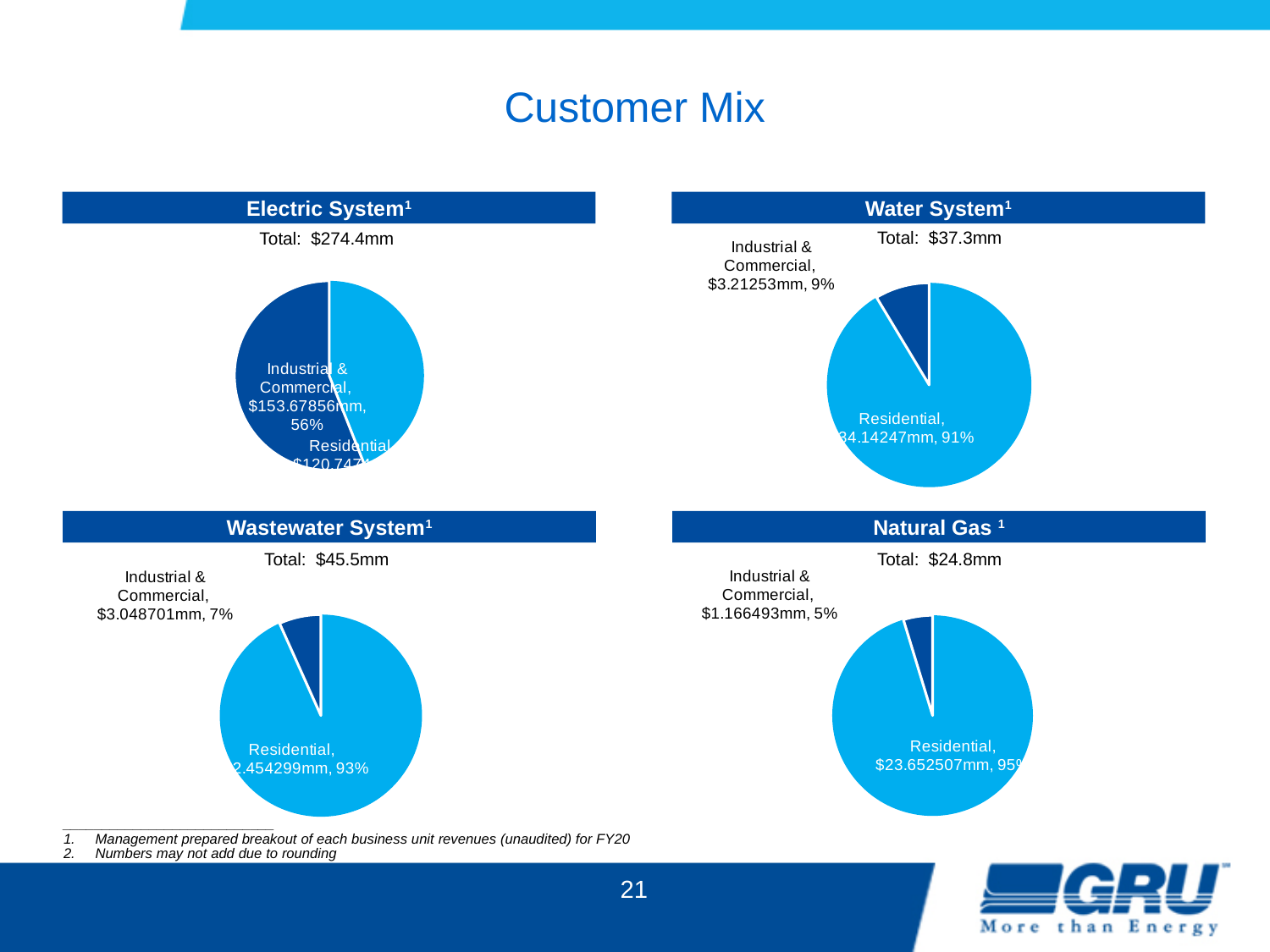
In the Wastewater System chart, what is the value for Industrial & Commercial? $3.048701mm In the Electric System chart, which slice is larger, Industrial & Commercial or Residential? Industrial & Commercial In the Natural Gas chart, what is the value for Residential? $23.652507mm In the Natural Gas chart, what share of the pie is Industrial & Commercial? 5% In the Wastewater System chart, what share of the pie is Residential? 93% What kind of chart is used for the Electric System? pie chart In the Water System chart, which slice is the largest? Residential In the Electric System chart, what is the value for Industrial & Commercial? $153.67856mm How many pie charts are shown on the slide? 4 In the Water System chart, what is the value for Industrial & Commercial? $3.21253mm In the Water System chart, what share of the pie is Residential? 91%